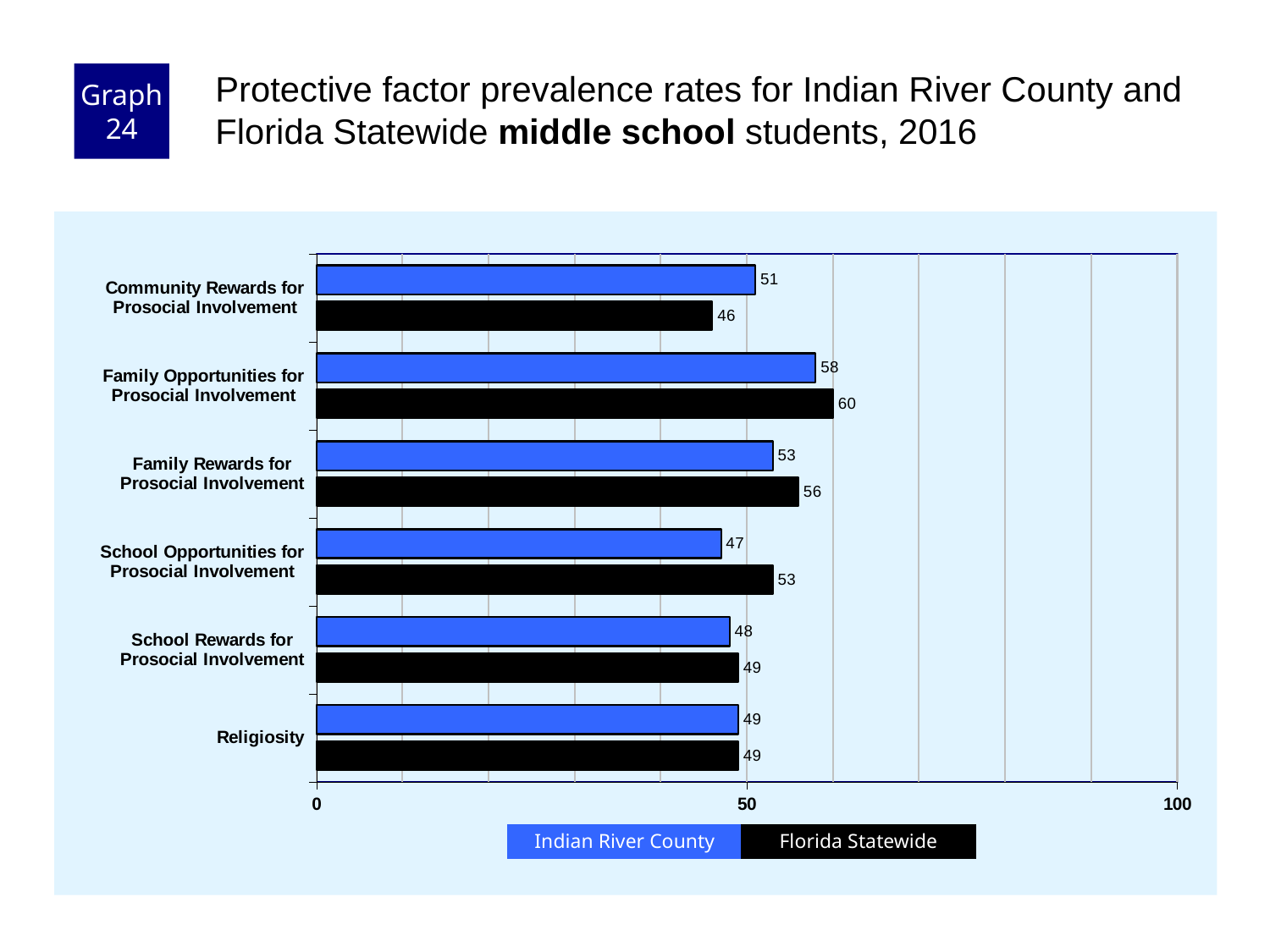
How many categories are shown on the chart? 6 Which colour represents Florida Statewide in the chart? black Which category has the highest Florida Statewide value? Family Opportunities for Prosocial Involvement Is the Florida Statewide value for Family Rewards for Prosocial Involvement greater or less than 50? greater What is the Florida Statewide value for Family Opportunities for Prosocial Involvement? 60 What kind of chart is shown on the slide? bar chart How many series does the legend list? 2 What is the Indian River County value for Community Rewards for Prosocial Involvement? 51 Which category has the lowest Indian River County value? School Opportunities for Prosocial Involvement For Community Rewards for Prosocial Involvement, which is larger: the Indian River County value or the Florida Statewide value? Indian River County What is the difference between the Florida Statewide and Indian River County values for School Opportunities for Prosocial Involvement? 6 What is the Indian River County value for School Opportunities for Prosocial Involvement? 47